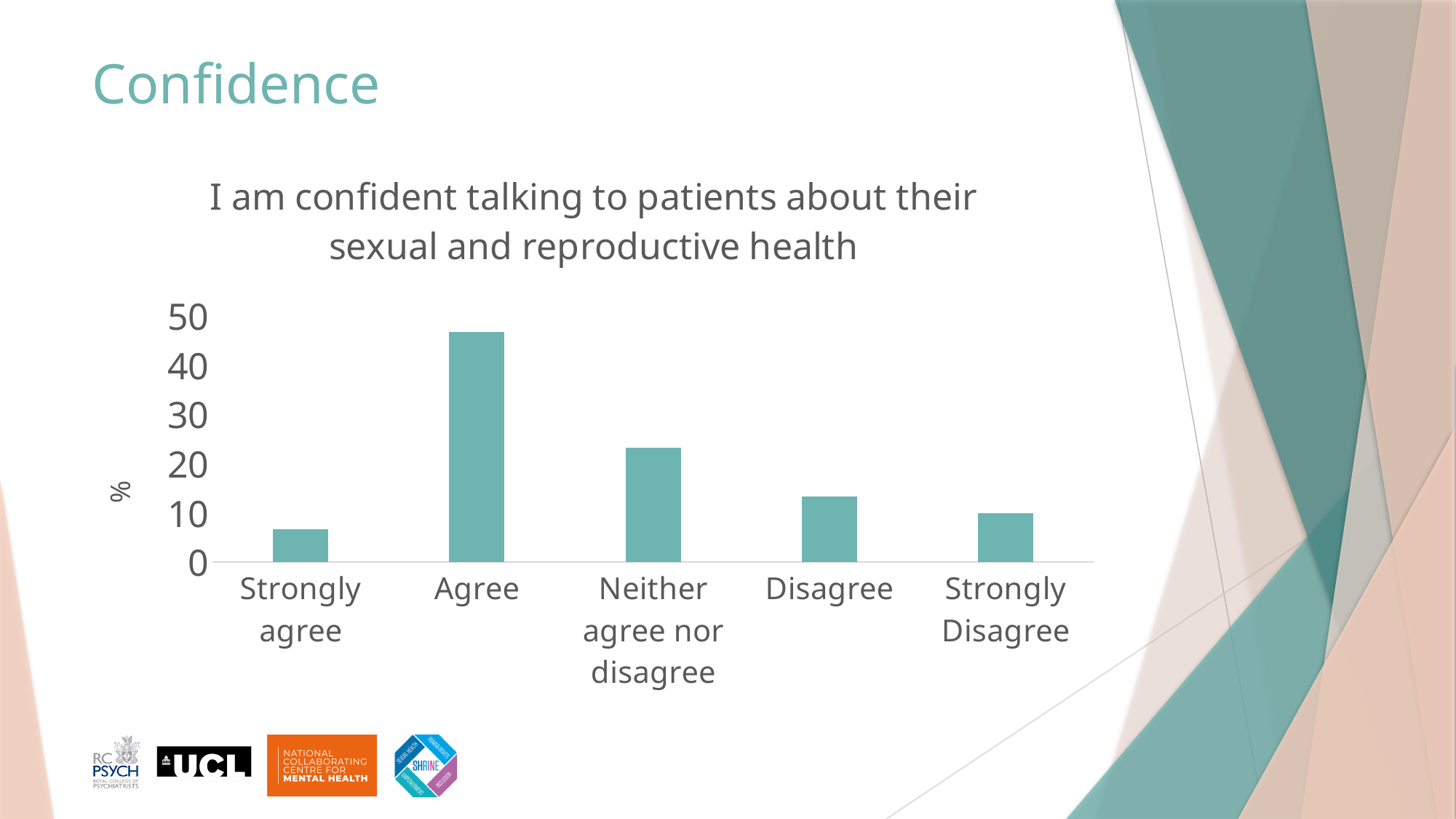
What is the title of the chart? I am confident talking to patients about their sexual and reproductive health Which is larger, the value for Agree or the value for Neither agree nor disagree? Agree Is the value for Agree greater or less than 40? greater Which category has the highest bar? Agree What kind of chart is shown on the slide? bar chart Which is larger, the value for Disagree or the value for Strongly agree? Disagree How many categories are shown on the x axis of the chart? 5 Is the value for Neither agree nor disagree greater or less than 30? less Which category has the lowest bar? Strongly agree Is the value for Agree greater or less than 50? less What is the label on the y axis of the chart? %